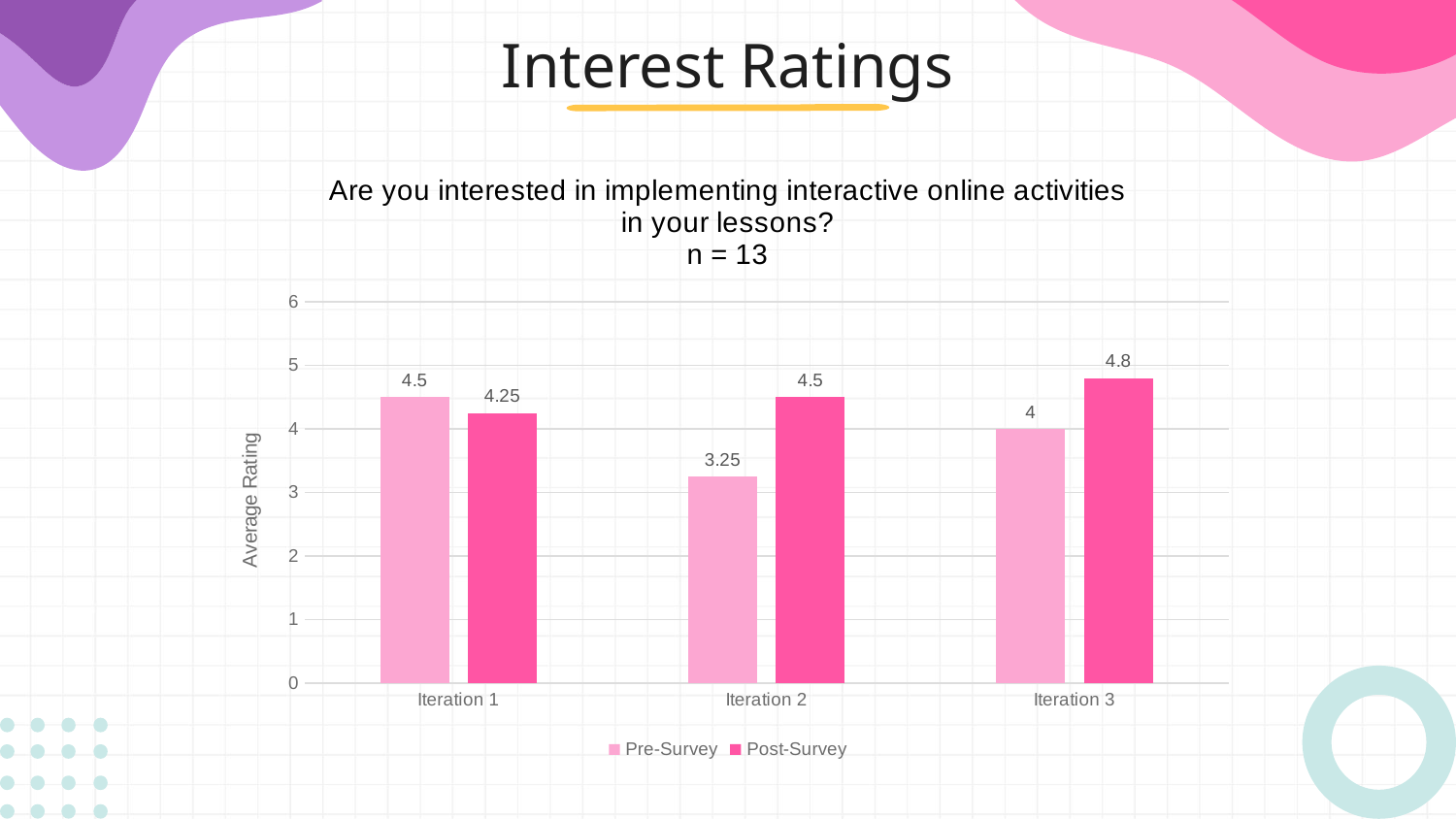
What is the Post-Survey value for Iteration 2? 4.5 What is the Pre-Survey value for Iteration 1? 4.5 How many series does the legend list? 2 How many iterations are shown on the x axis? 3 What is the Pre-Survey value for Iteration 2? 3.25 Which iteration has the lowest Pre-Survey value? Iteration 2 What kind of chart is shown on the slide? Bar chart What is the Post-Survey value for Iteration 3? 4.8 Which iteration has the highest Post-Survey value? Iteration 3 What is the difference between the Pre-Survey and Post-Survey values for Iteration 1? 0.25 Which is larger for Iteration 3, the Pre-Survey or the Post-Survey value? Post-Survey What is the difference between the Post-Survey and Pre-Survey values for Iteration 2? 1.25